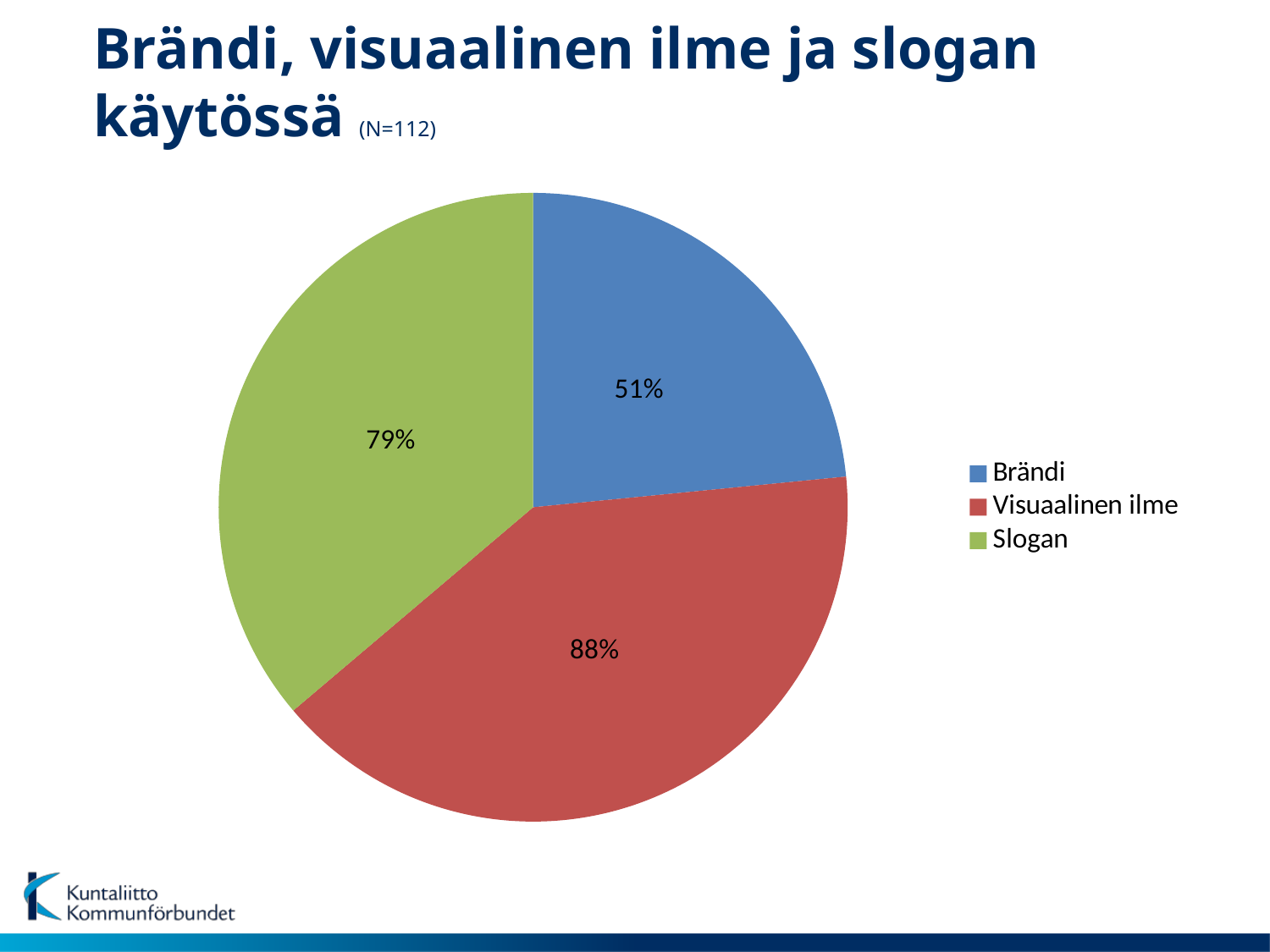
What is the difference between the values for Slogan and Brändi? 28% What value is shown for the Visuaalinen ilme slice? 88% What value is shown for the Brändi slice? 51% Which category has the lowest value in the pie chart? Brändi Which is larger, the value for Slogan or the value for Brändi? Slogan What colour is the Slogan slice in the pie chart? green What kind of chart is shown on the slide? pie chart What value is shown for the Slogan slice? 79% Which category has the highest value in the pie chart? Visuaalinen ilme How many entries does the legend list? 3 How many slices does the pie chart have? 3 What is the difference between the values for Visuaalinen ilme and Brändi? 37%